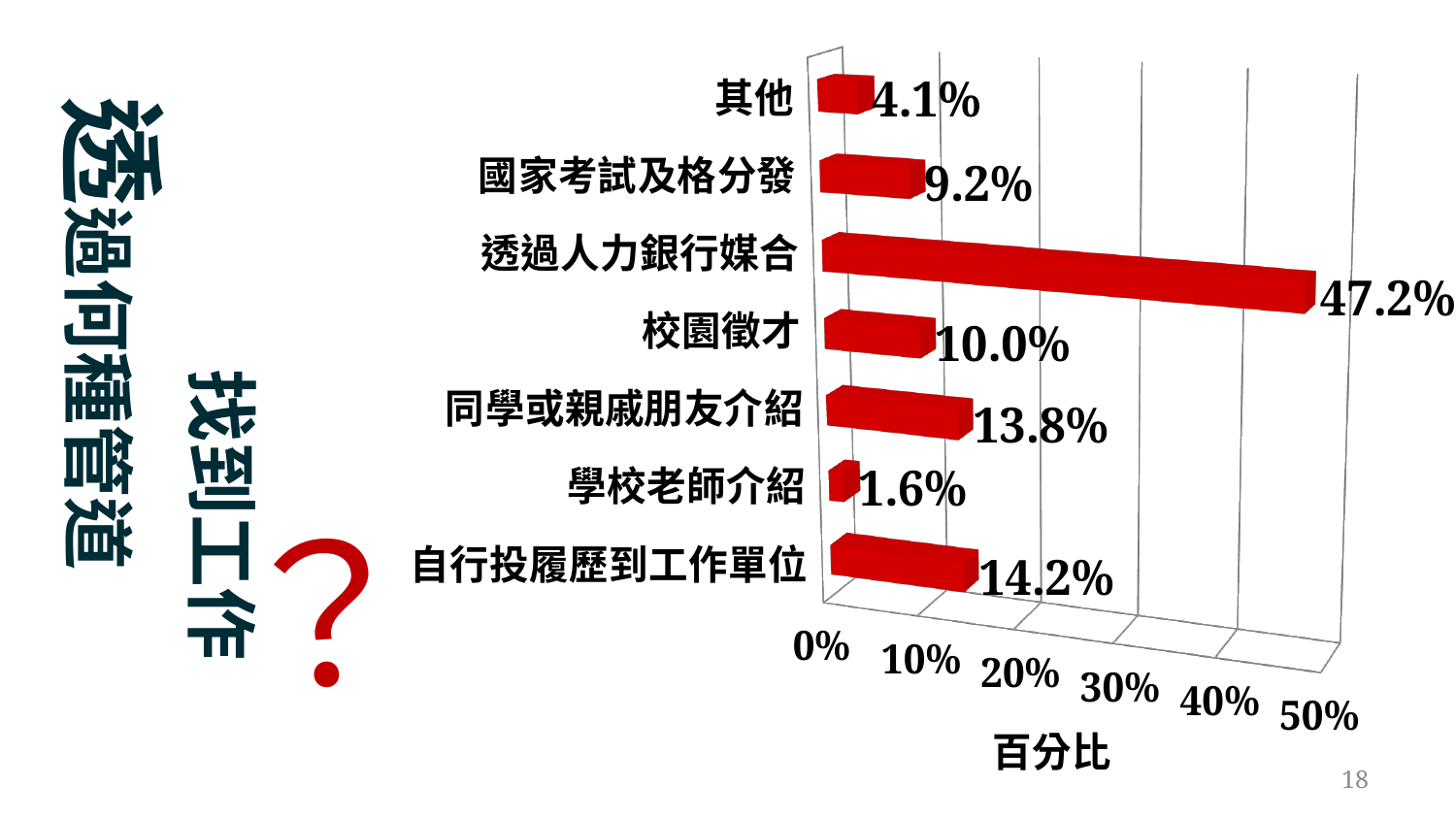
Which category has the highest value? 透過人力銀行媒合 What is the value for 學校老師介紹? 1.6% What is the difference between 同學或親戚朋友介紹 and 校園徵才? 3.8% What is the value for 透過人力銀行媒合? 47.2% What is the value for 國家考試及格分發? 9.2% What kind of chart is this? bar chart Which category has the lowest value? 學校老師介紹 What is the difference between 透過人力銀行媒合 and 自行投履歷到工作單位? 33.0% What is the value for 自行投履歷到工作單位? 14.2% Which is larger, 校園徵才 or 國家考試及格分發? 校園徵才 How many categories are shown in the chart? 7 What is the label of the horizontal axis? 百分比